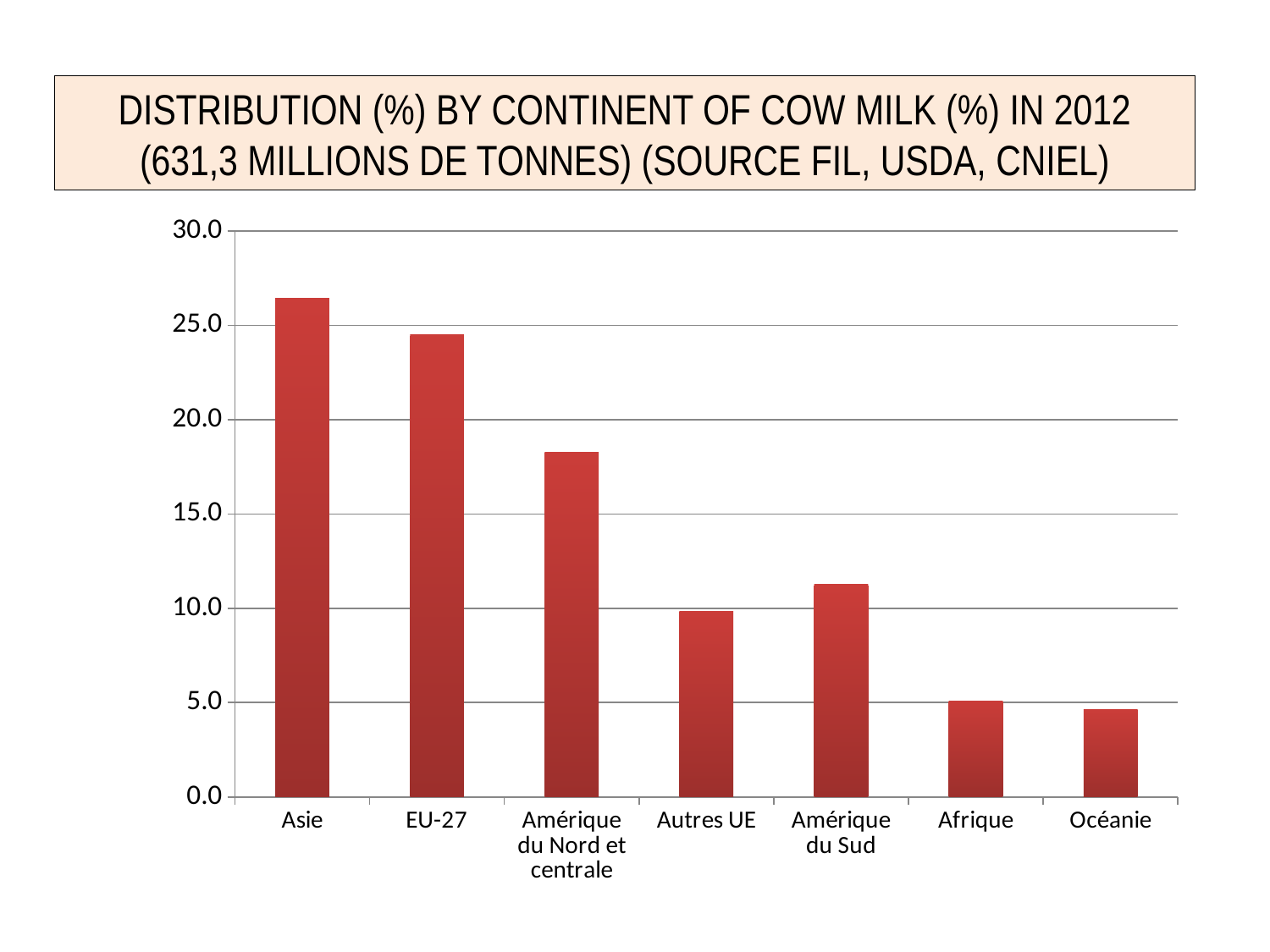
Is the value for Océanie greater or less than 5.0? less Which is larger, the value for Amérique du Sud or the value for Autres UE? Amérique du Sud Is the value for EU-27 greater or less than 20.0? greater Which region has the lowest share of cow milk production? Océanie Is the value for Asie greater or less than 25.0? greater How many continents/regions are shown on the x axis? 7 Which is larger, the value for EU-27 or the value for Amérique du Nord et centrale? EU-27 What kind of chart is shown on the slide? bar chart What is the maximum value shown on the y axis? 30.0 Which region has the highest share of cow milk production? Asie